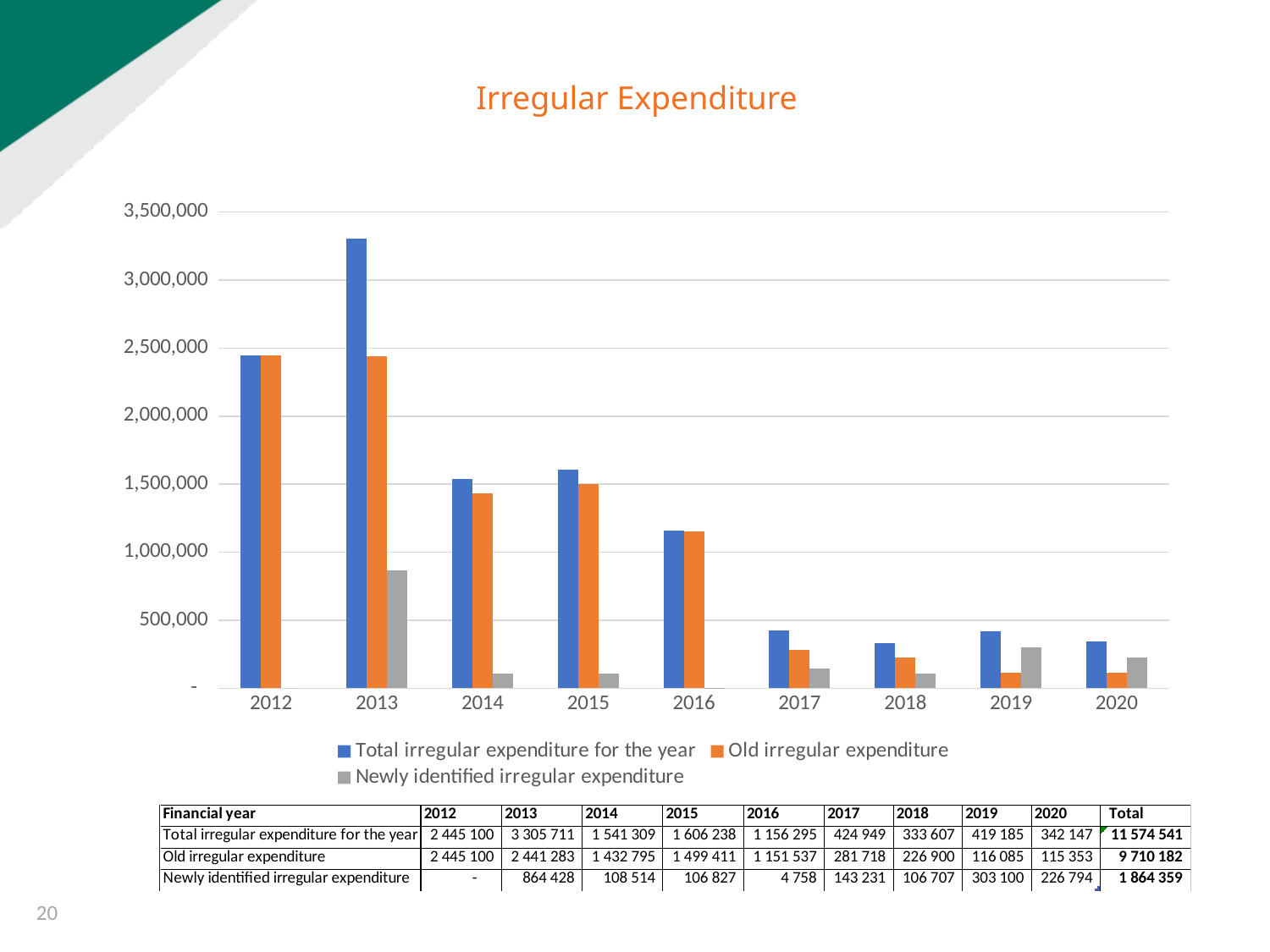
Which year has the highest total irregular expenditure for the year? 2013 What is the difference between the total irregular expenditure for the year in 2012 and in 2020? 2 102 953 How many financial years are shown on the x axis? 9 Is the total irregular expenditure for the year in 2017 greater or less than 500,000? less What type of chart is shown on the slide? bar chart Which year has the lowest total irregular expenditure for the year? 2018 Which is larger, the newly identified irregular expenditure in 2013 or in 2014? 2013 What is the newly identified irregular expenditure in 2019? 303 100 What is the old irregular expenditure in 2016? 1 151 537 How many series does the legend list? 3 What is the total irregular expenditure for the year in 2013? 3 305 711 What is the title of the chart? Irregular Expenditure